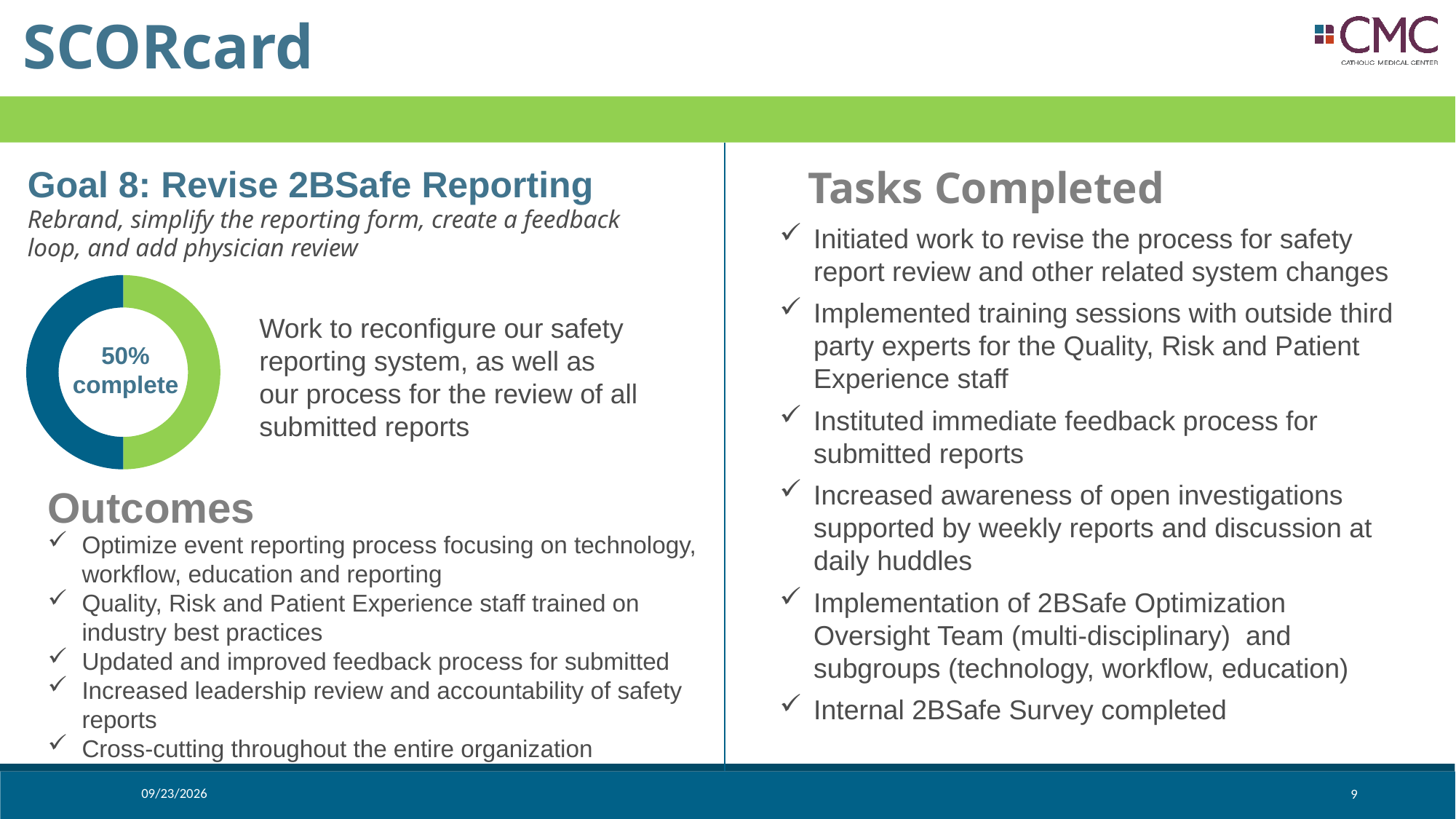
What percentage complete does the doughnut chart show? 50% complete How many slices does the doughnut chart have? 2 Is the completed share shown in the doughnut chart greater or less than 75%? less What kind of chart is shown on the slide? Doughnut chart Is the completed share shown in the doughnut chart greater or less than 25%? greater What share of the doughnut chart is marked as complete? 50% What two colours are used for the slices of the doughnut chart? Blue and green What text is printed in the centre of the doughnut chart? 50% complete